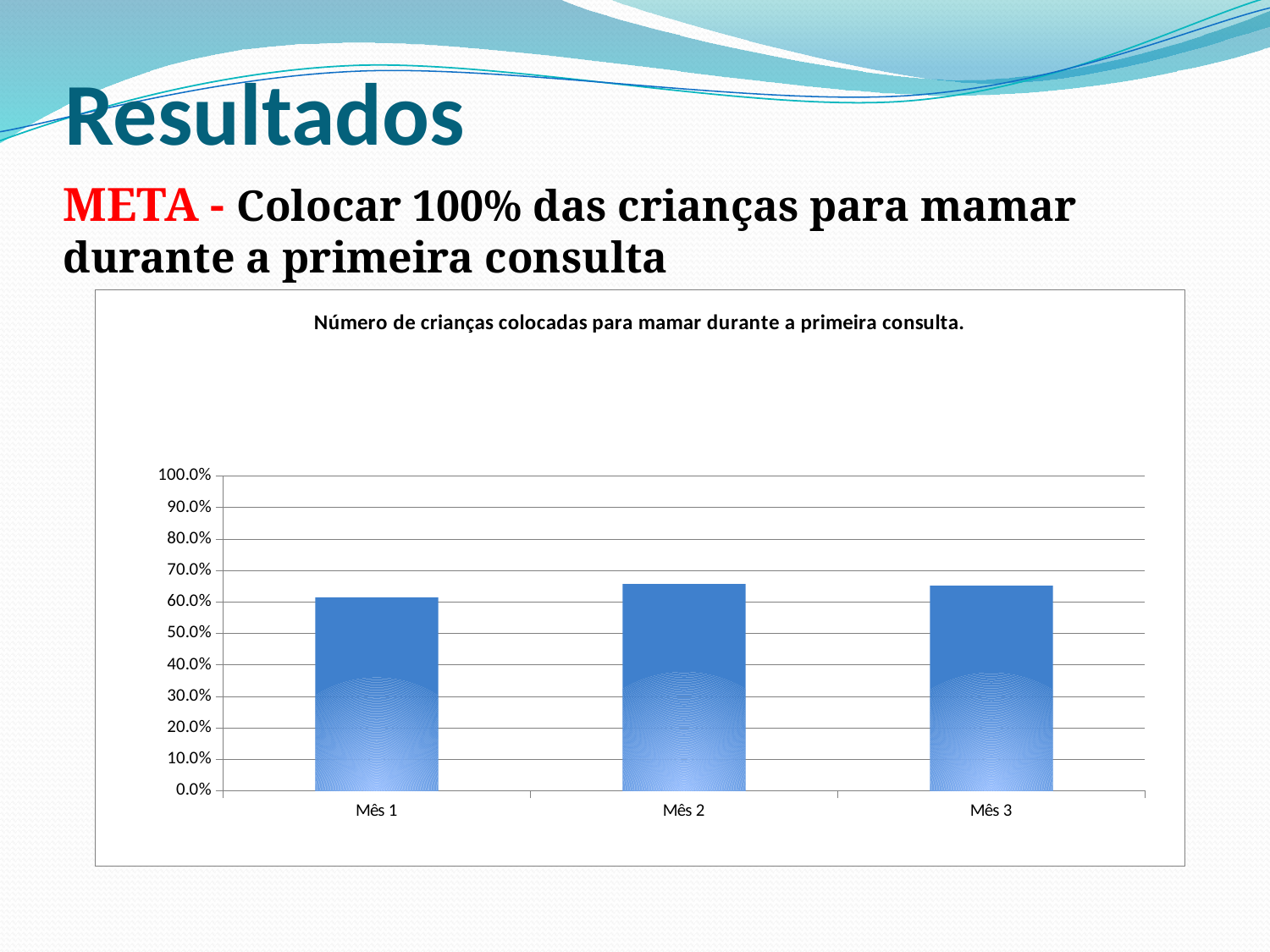
What kind of chart is shown on the slide? bar chart Is the value for Mês 1 greater or less than 70.0%? less Is the value for Mês 2 greater or less than 60.0%? greater Is the value for Mês 2 greater or less than 70.0%? less What is the highest value shown on the vertical axis of the chart? 100.0% How many categories (months) are plotted on the chart? 3 Which month has the lowest value on the chart? Mês 1 Which is larger, the value for Mês 1 or the value for Mês 3? Mês 3 What is the title of the chart? Número de crianças colocadas para mamar durante a primeira consulta. Which is larger, the value for Mês 1 or the value for Mês 2? Mês 2